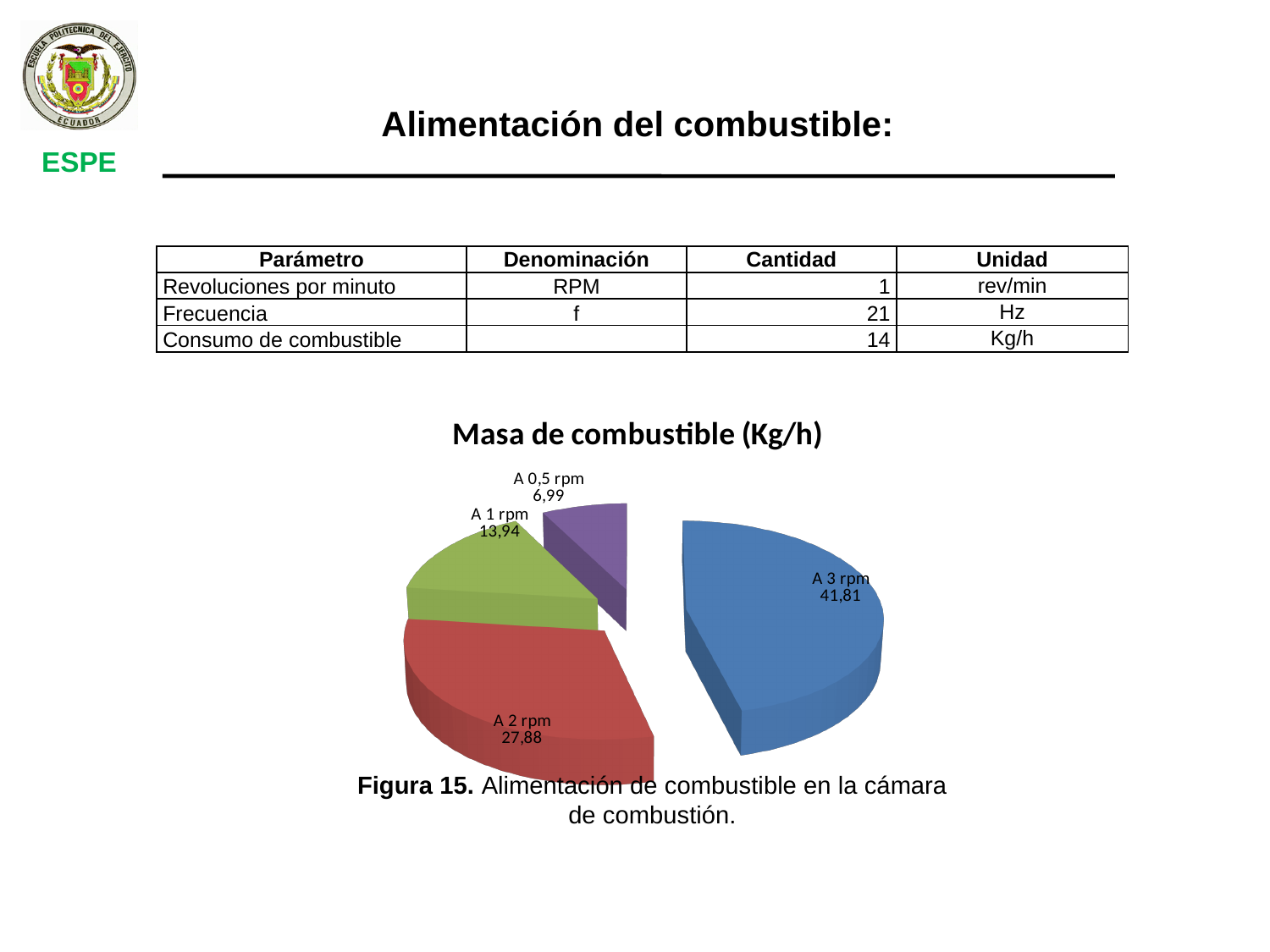
What type of chart is shown on the slide? Pie chart Which category has the smallest slice? A 0,5 rpm What is the value for A 2 rpm? 27,88 What colour is the A 3 rpm slice? Blue What is the difference between the values for A 3 rpm and A 2 rpm? 13,93 What is the title of the chart? Masa de combustible (Kg/h) Which category has the largest slice? A 3 rpm What is the value for A 1 rpm? 13,94 Which is larger, the value for A 2 rpm or the value for A 1 rpm? A 2 rpm What is the value for A 3 rpm? 41,81 How many slices does the pie chart have? 4 What is the value for A 0,5 rpm? 6,99